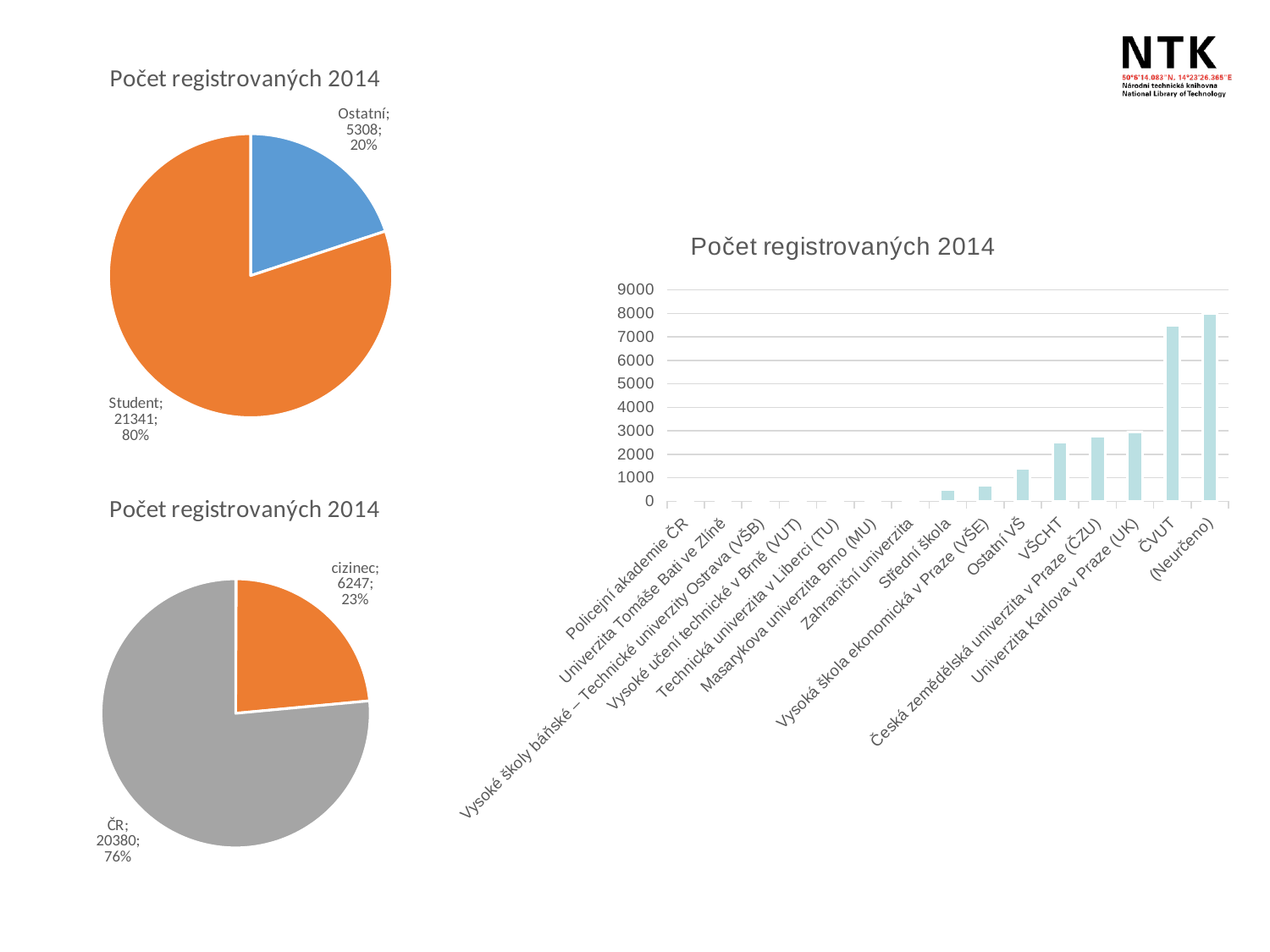
How many categories are shown in the bar chart on the right? 15 In the top-left pie chart, what is the difference between the Student and Ostatní values? 16033 In the bar chart on the right, which category has the highest value? (Neurčeno) In the bottom-left pie chart, which slice is larger, ČR or cizinec? ČR In the top-left pie chart, what is the value for Student? 21341 In the bottom-left pie chart, what is the value for cizinec? 6247 In the bar chart on the right, is the value for ČVUT greater or less than 7000? greater In the top-left pie chart, what share of the pie does Ostatní represent? 20% In the bottom-left pie chart, what is the difference between the ČR and cizinec values? 14133 What type of chart is the chart on the right side of the slide? Bar chart In the bottom-left pie chart, what share of the pie does ČR represent? 76% In the bar chart on the right, is the value for VŠCHT greater or less than 3000? less